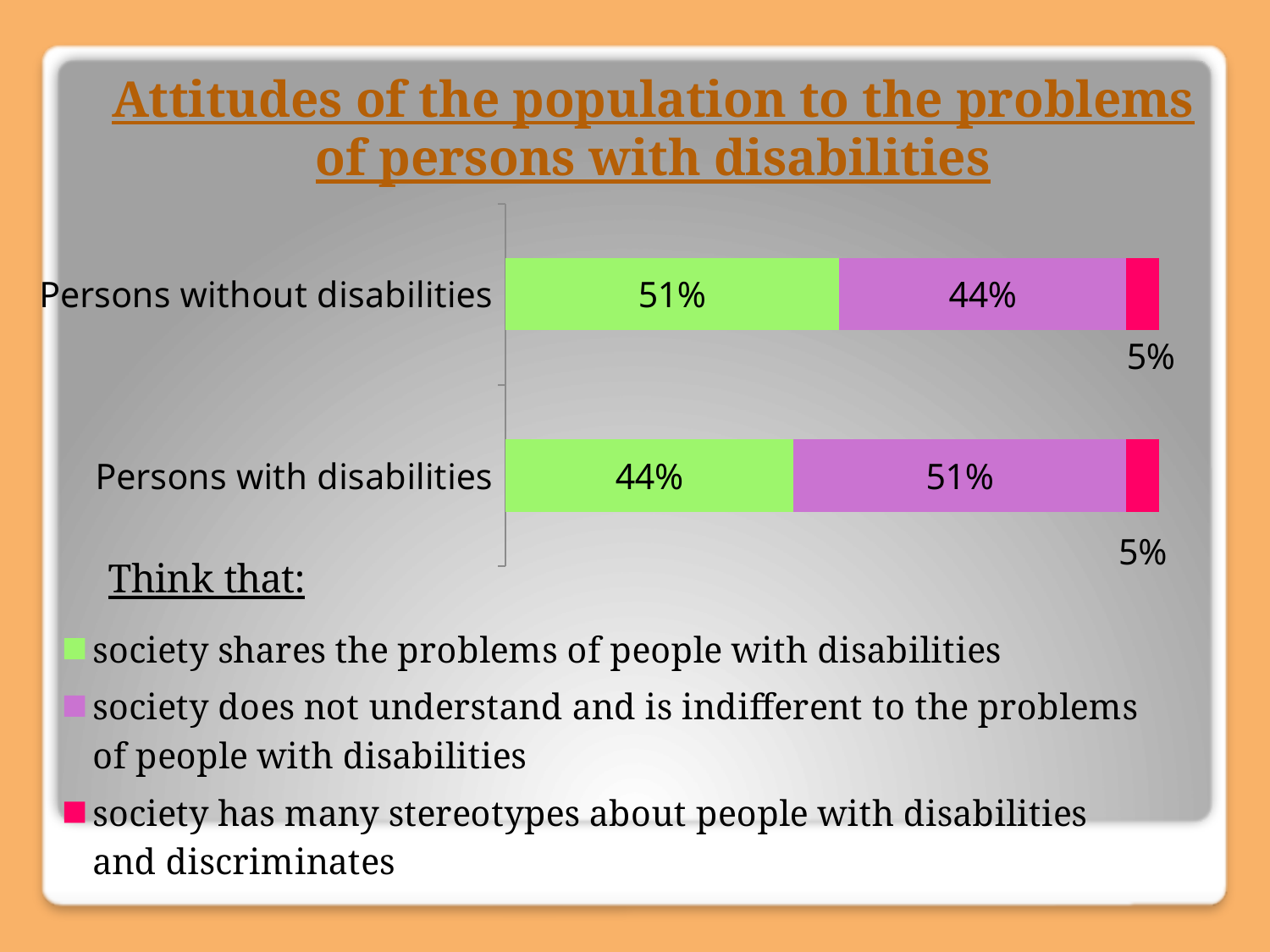
Which colour represents the opinion that society has many stereotypes about people with disabilities and discriminates? Pink What percentage of persons with disabilities think that society does not understand and is indifferent to the problems of people with disabilities? 51% How many categories (groups of persons) are shown on the chart? 2 What percentage of persons without disabilities think that society shares the problems of people with disabilities? 51% Which group has the larger share thinking that society shares the problems of people with disabilities: persons with disabilities or persons without disabilities? Persons without disabilities What is the difference between the share of persons without disabilities and persons with disabilities who think society shares the problems of people with disabilities? 7% What percentage of persons with disabilities think that society has many stereotypes about people with disabilities and discriminates? 5% What is the title of the chart? Attitudes of the population to the problems of persons with disabilities How many series does the legend list? 3 What percentage of persons without disabilities think that society does not understand and is indifferent to the problems of people with disabilities? 44% What kind of chart is shown on the slide? bar chart What is the total of the stacked bar for persons with disabilities? 100%